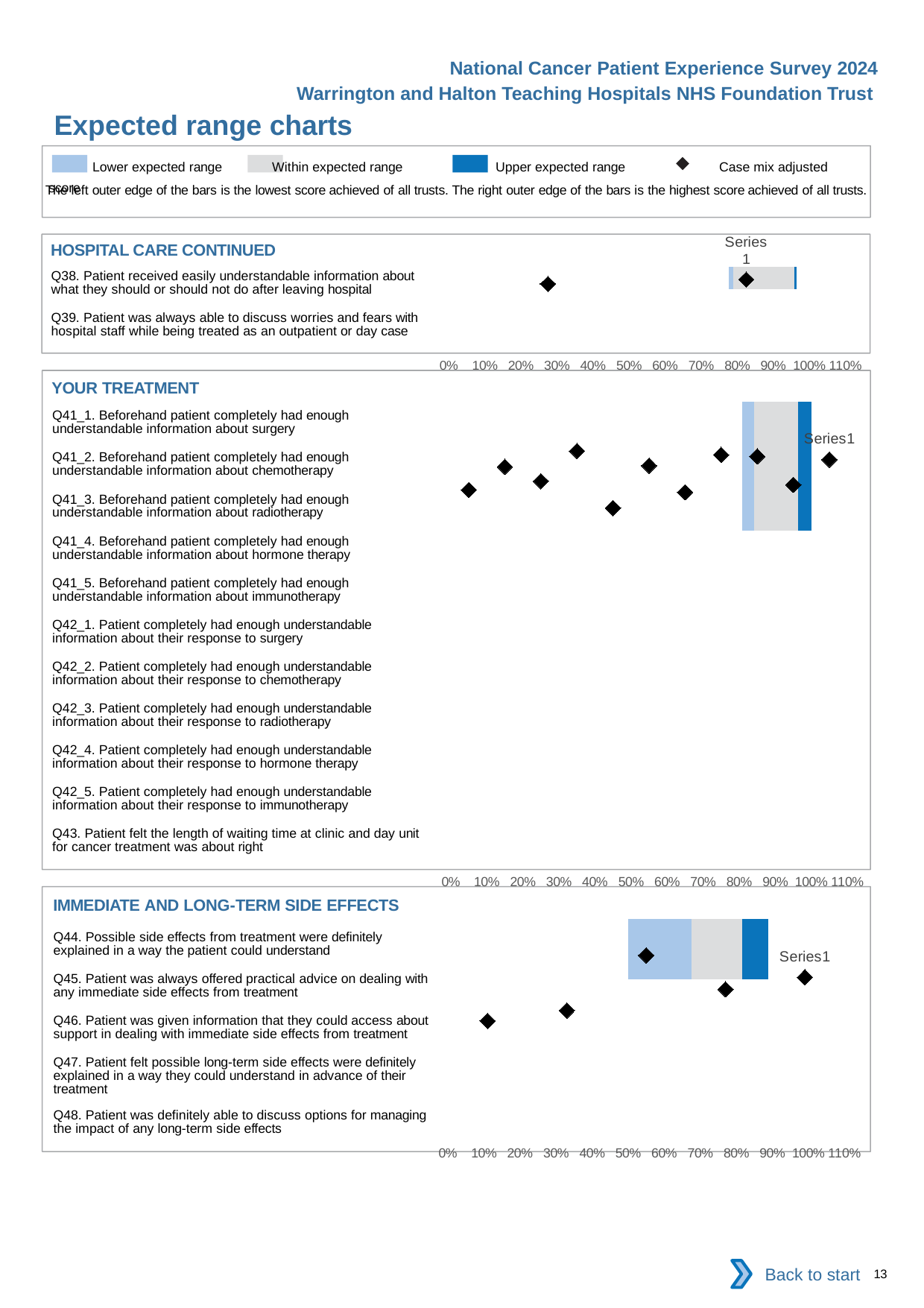
How many diamond markers are plotted in the YOUR TREATMENT chart? 11 What symbol does the legend use for the Case mix adjusted score? A diamond How many diamond markers are plotted in the IMMEDIATE AND LONG-TERM SIDE EFFECTS chart? 5 How many questions are listed in the YOUR TREATMENT chart? 11 What is the highest tick label shown on the x axis of the YOUR TREATMENT chart? 110% How many entries does the legend at the top of the slide list? 4 What is the title of the chart section that contains Q44 to Q48? IMMEDIATE AND LONG-TERM SIDE EFFECTS In the legend, which colour represents the Upper expected range? Dark blue